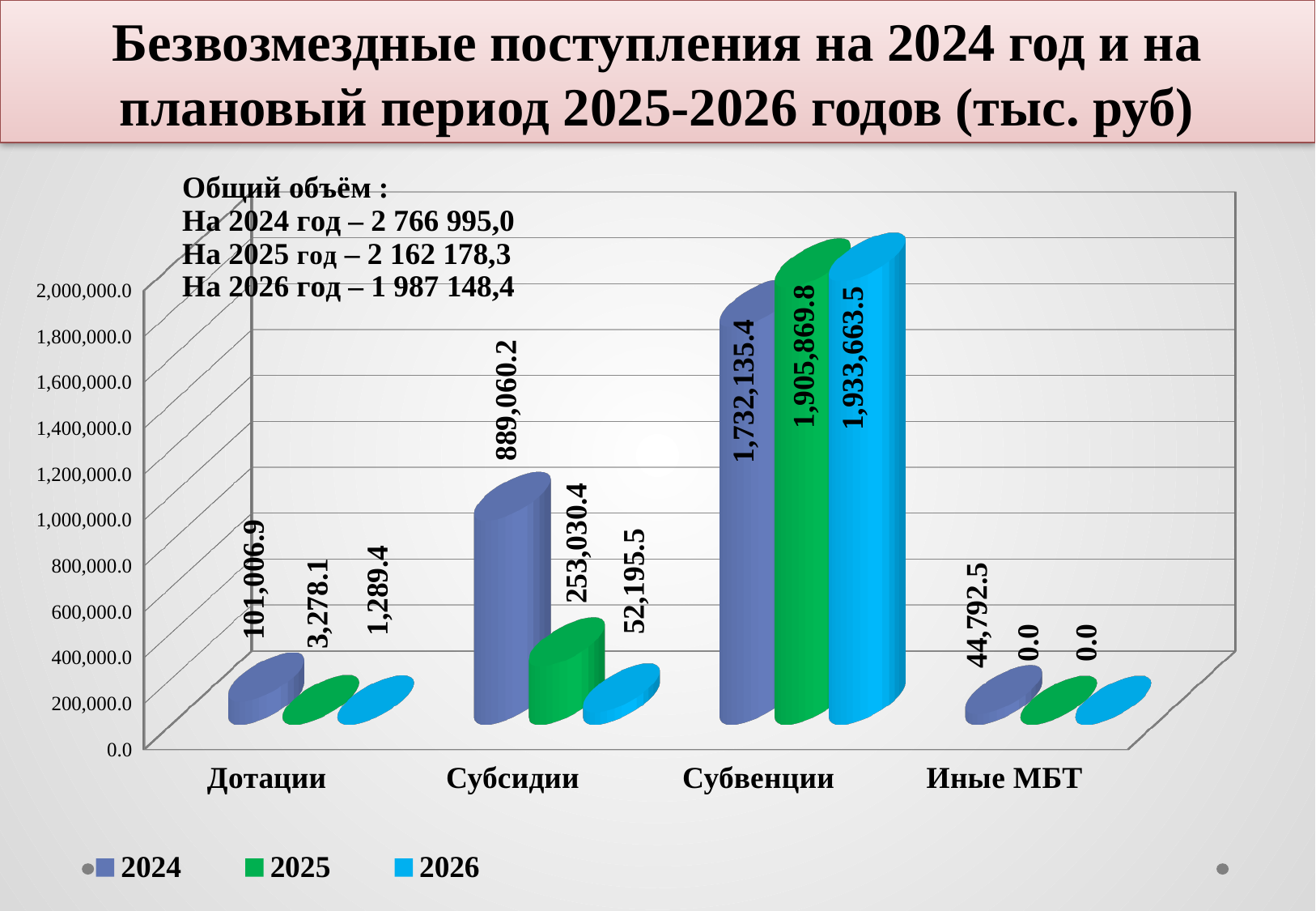
Which category has the lowest value in the 2026 series? Иные МБТ What kind of chart is shown on the slide? Bar chart How many categories are shown on the x axis? 4 What is the value for Иные МБТ in the 2025 series? 0.0 How many series does the legend list? 3 What is the difference between the 2024 and 2026 values for Субсидии? 836,864.7 Which colour represents the 2025 series in the legend? Green Which category has the highest value in the 2024 series? Субвенции What is the value for Субвенции in the 2026 series? 1,933,663.5 Which is larger for Субвенции: the 2024 value or the 2025 value? 2025 What is the value for Субсидии in the 2025 series? 253,030.4 What is the value for Дотации in the 2024 series? 101,006.9